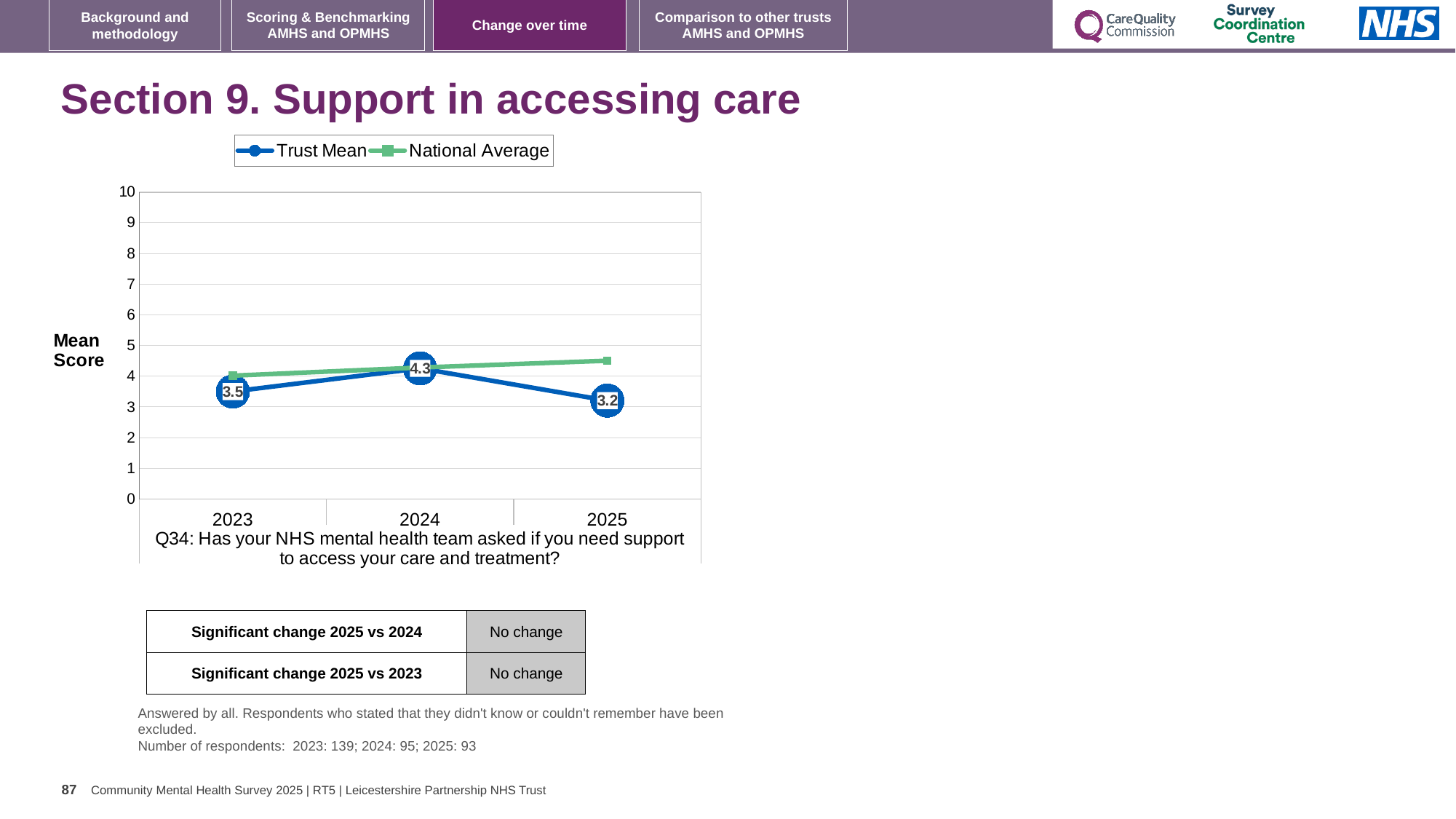
How many years are shown on the x axis? 3 Is the National Average value for 2025 greater or less than 4? greater Does the National Average rise or fall from 2023 to 2025? Rise What is the Trust Mean score for 2024? 4.3 What is the Trust Mean score for 2023? 3.5 What is the difference between the Trust Mean in 2024 and in 2025? 1.1 How many series does the legend list? 2 What is the Trust Mean score for 2025? 3.2 What kind of chart is shown on the slide? Line chart Which is larger, the Trust Mean in 2023 or in 2025? 2023 In which year is the Trust Mean highest? 2024 In which year is the Trust Mean lowest? 2025